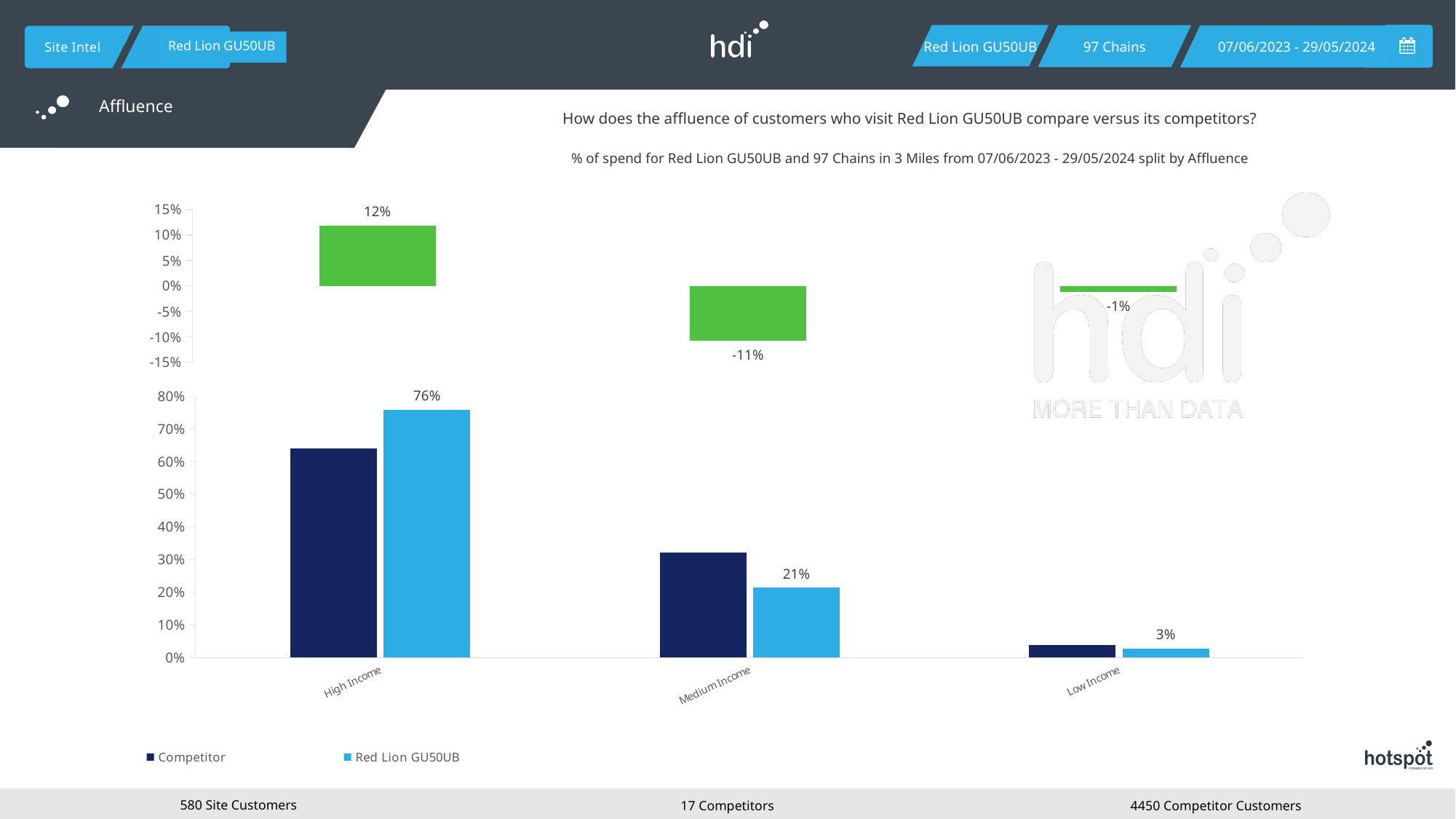
In the top chart, which category has the lowest value? Medium Income In the bottom chart, which category has the highest value for Red Lion GU50UB? High Income How many series does the legend of the bottom chart list? 2 In the bottom chart, what is the value for Red Lion GU50UB in the Medium Income category? 21% In the bottom chart, which is larger for Medium Income: Competitor or Red Lion GU50UB? Competitor In the top chart, what is the value shown for the Low Income category? -1% In the bottom chart, what is the value for Red Lion GU50UB in the High Income category? 76% In the top chart, what is the value shown for the Medium Income category? -11% In the top chart, what is the value shown for the High Income category? 12% In the bottom chart, what is the difference between the Red Lion GU50UB values for High Income and Medium Income? 55% In the bottom chart, is the Competitor value for High Income greater or less than 50%? greater In the bottom chart, what is the value for Red Lion GU50UB in the Low Income category? 3%